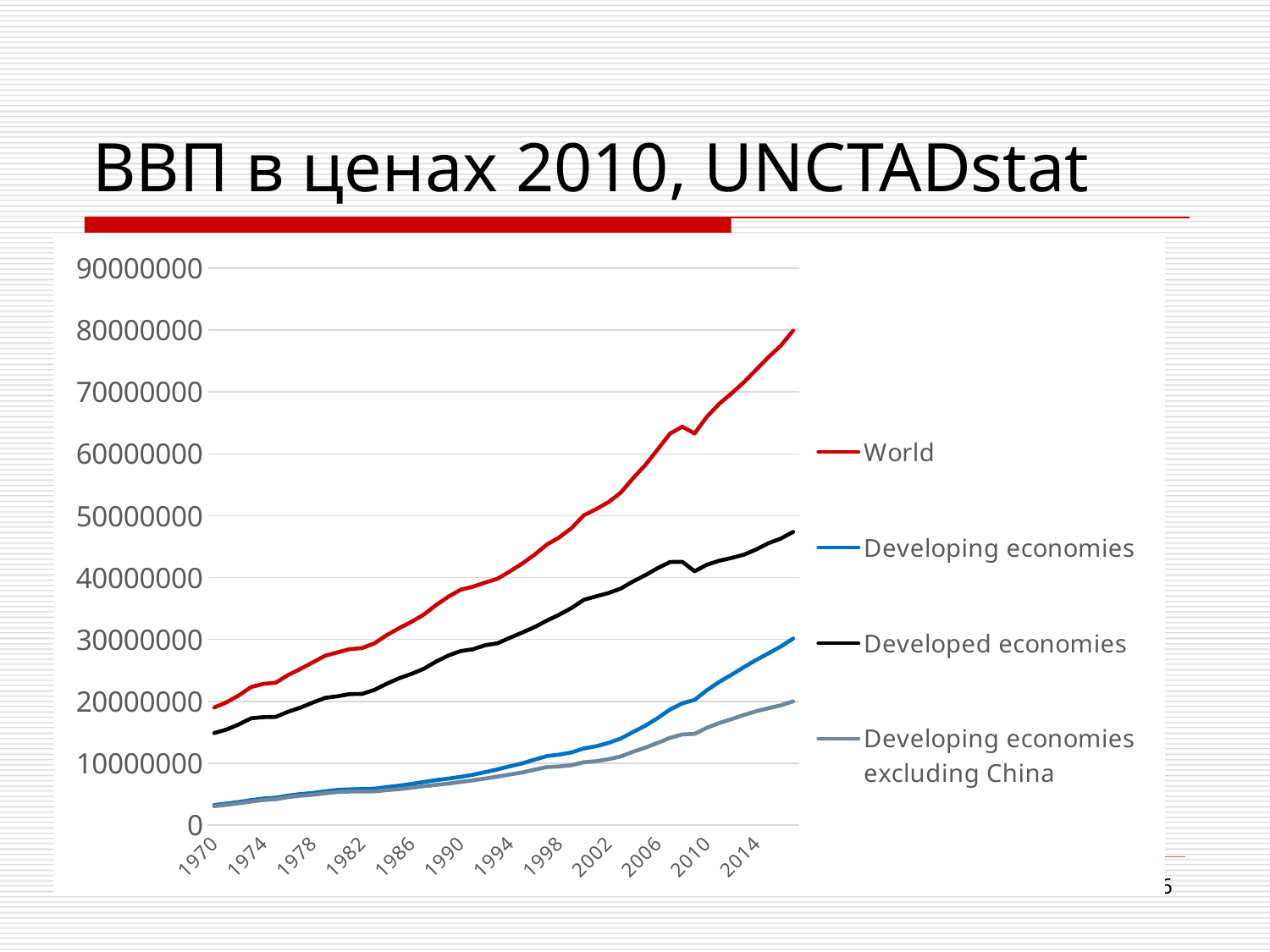
What is the title of the slide? ВВП в ценах 2010, UNCTADstat Which series has the lowest values at the end of the period? Developing economies excluding China How many year labels are shown on the x axis? 12 Is the value for World in 1970 greater or less than 30000000? less Which series is drawn in red? World Does the World series rise or fall overall from 1970 to the end of the period? rise Which series has the highest values across the whole period? World How many series does the legend list? 4 Is the value for Developed economies in 2014 greater or less than 40000000? greater In 2014, which is larger: Developing economies or Developing economies excluding China? Developing economies Is the value for World in 2014 greater or less than 70000000? greater What kind of chart is shown on the slide? line chart